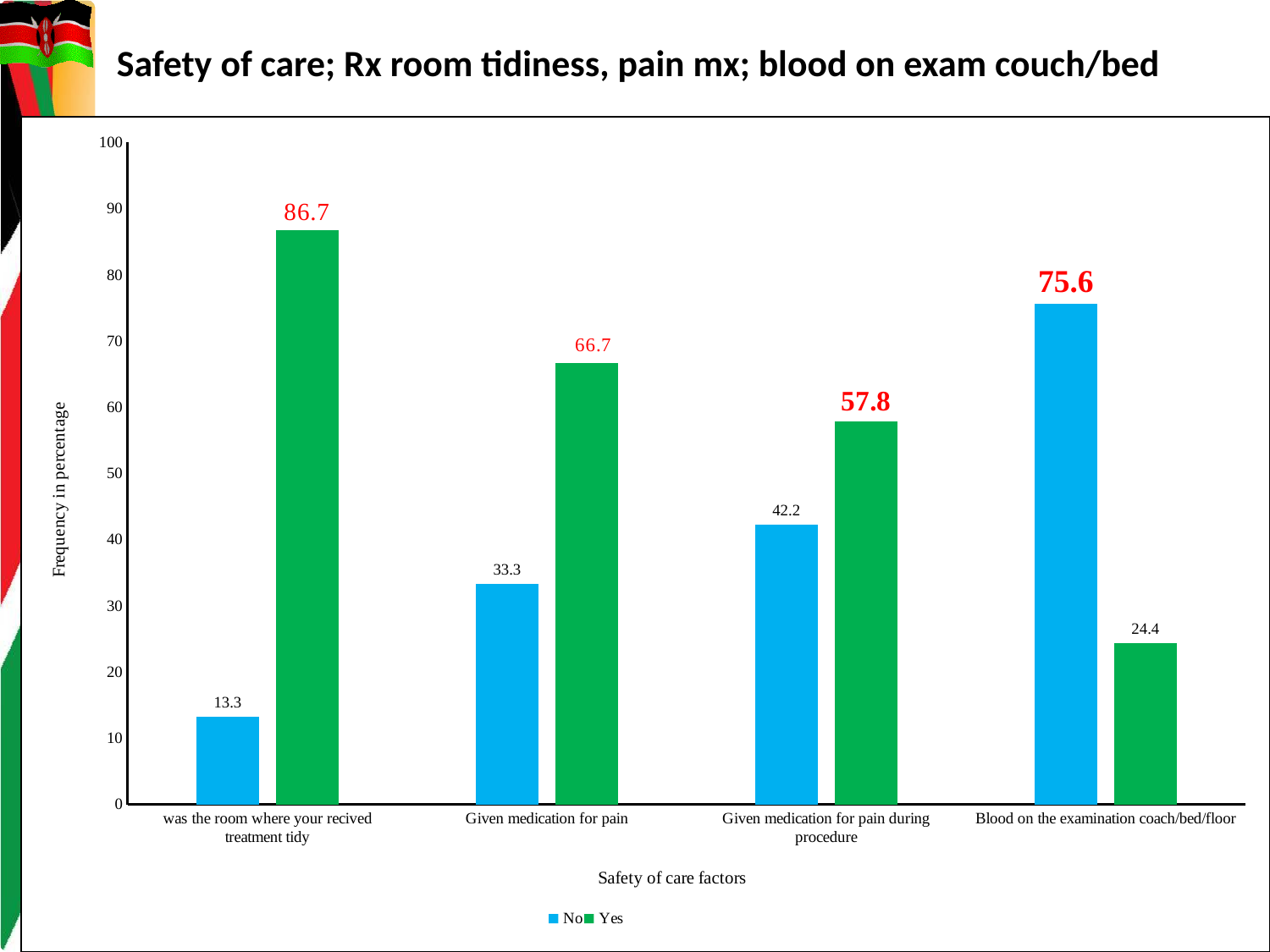
Which category has the lowest 'Yes' value? Blood on the examination coach/bed/floor What is the difference between the 'Yes' and 'No' values for 'Given medication for pain'? 33.4 What is the 'Yes' value for 'Blood on the examination coach/bed/floor'? 24.4 What is the 'Yes' value for 'was the room where your recived treatment tidy'? 86.7 What kind of chart is shown on the slide? bar chart Which category has the highest 'No' value? Blood on the examination coach/bed/floor What is the label of the y axis? Frequency in percentage For 'Given medication for pain during procedure', which is larger, the 'Yes' value or the 'No' value? Yes What is the 'No' value for 'Given medication for pain during procedure'? 42.2 How many categories are shown on the x axis? 4 How many series does the legend list? 2 Is the 'No' value for 'was the room where your recived treatment tidy' greater or less than 20? less